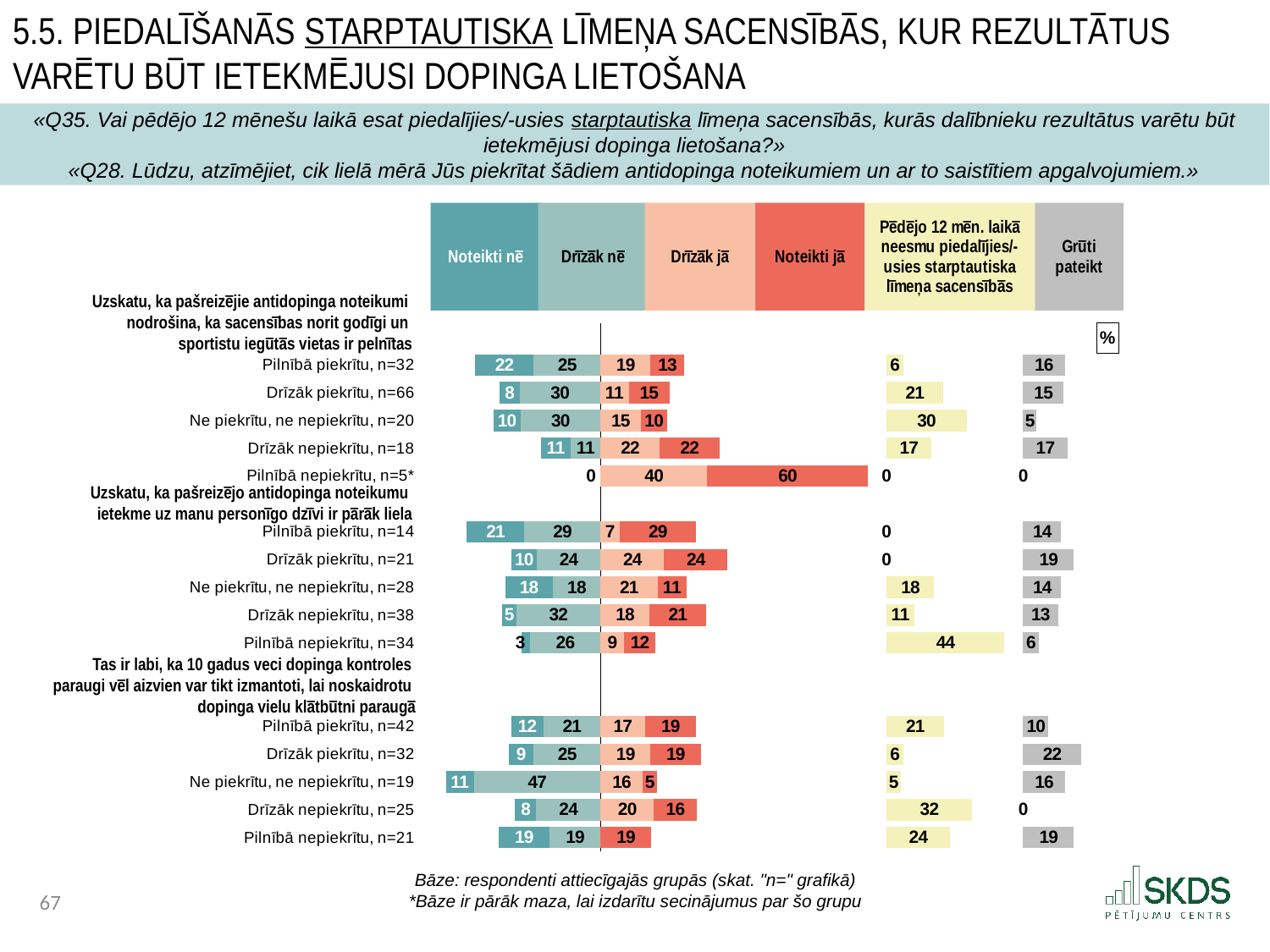
Which group has the highest 'Drīzāk nē' value? Ne piekrītu, ne nepiekrītu, n=19 What is the 'Drīzāk nē' value for 'Ne piekrītu, ne nepiekrītu, n=19'? 47 How many series does the legend list? 6 What kind of chart is shown on the slide? bar chart What is the 'Grūti pateikt' value for 'Drīzāk nepiekrītu, n=25'? 0 For 'Drīzāk piekrītu, n=66', what is the difference between the 'Drīzāk nē' value and the 'Noteikti nē' value? 22 Which group has the highest 'Noteikti jā' value? Pilnībā nepiekrītu, n=5* Which has the larger 'Grūti pateikt' value: 'Drīzāk piekrītu, n=32' or 'Pilnībā piekrītu, n=42'? Drīzāk piekrītu, n=32 What is the total of the 'Noteikti nē', 'Drīzāk nē', 'Drīzāk jā' and 'Noteikti jā' segments for 'Pilnībā piekrītu, n=32'? 79 What is the 'Pēdējo 12 mēn. laikā neesmu piedalījies/-usies starptautiska līmeņa sacensībās' value for 'Pilnībā nepiekrītu, n=34'? 44 What is the 'Noteikti jā' value for the group 'Pilnībā nepiekrītu, n=5*' under the first statement? 60 How many respondent groups (rows) are plotted in the chart? 15